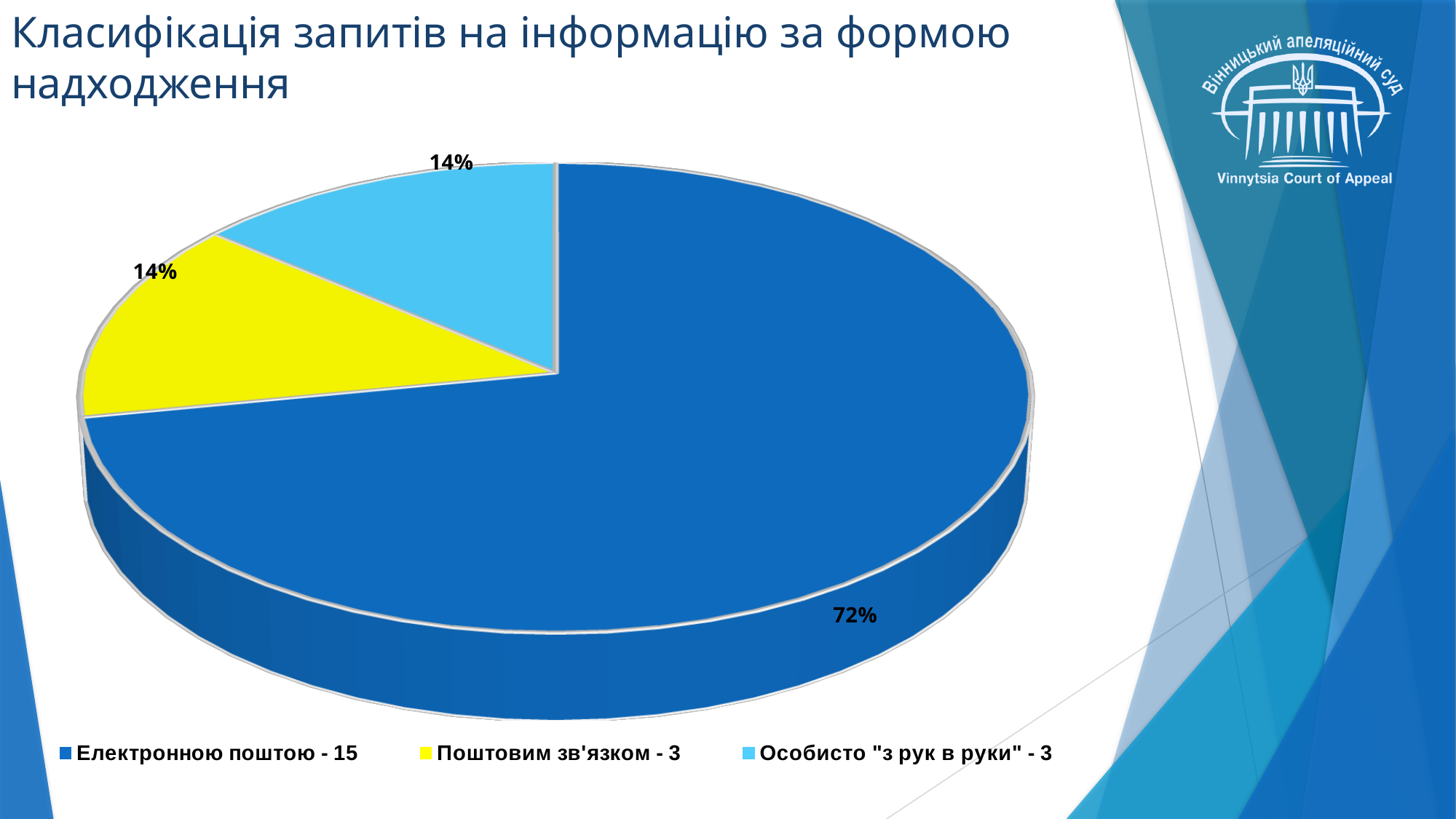
What is the title of the slide containing the pie chart? Класифікація запитів на інформацію за формою надходження What percentage share does the slice for "Електронною поштою" have? 72% What percentage share does the slice for "Поштовим зв'язком" have? 14% What kind of chart is shown on the slide? pie chart According to the legend, how many requests were received by "Електронною поштою"? 15 What colour is the slice for "Поштовим зв'язком"? yellow Which is larger: the share for "Електронною поштою" or the share for "Особисто "з рук в руки""? Електронною поштою What percentage share does the slice for "Особисто "з рук в руки"" have? 14% Which category has the largest slice of the pie? Електронною поштою According to the legend, how many requests were received by "Поштовим зв'язком"? 3 What is the difference in percentage points between the "Електронною поштою" slice and the "Поштовим зв'язком" slice? 58 How many slices does the pie chart have? 3